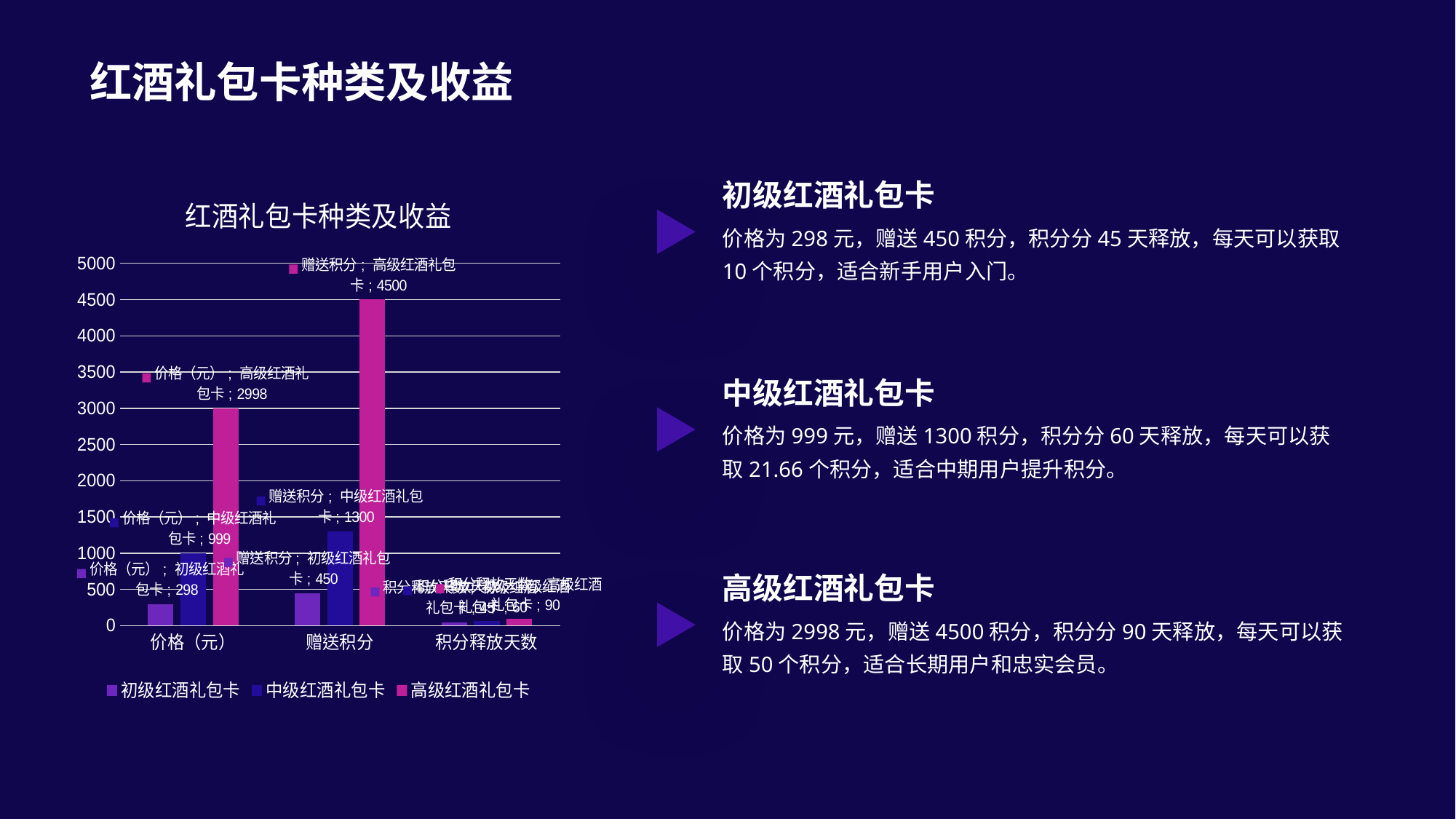
What is the difference between the 赠送积分 values of 高级红酒礼包卡 and 初级红酒礼包卡? 4050 How many series does the chart legend list? 3 Which series has the lowest 价格（元） value? 初级红酒礼包卡 How many categories are shown on the x axis of the chart? 3 What is the 价格（元） value for 初级红酒礼包卡? 298 Is the 积分释放天数 value for 高级红酒礼包卡 greater or less than 500? less What is the 价格（元） value for 高级红酒礼包卡? 2998 Which series has the highest 赠送积分 value? 高级红酒礼包卡 What type of chart is shown on the slide? bar chart What is the 赠送积分 value for 中级红酒礼包卡? 1300 Which is larger: the 价格（元） value for 中级红酒礼包卡 or the 赠送积分 value for 中级红酒礼包卡? 赠送积分 for 中级红酒礼包卡 What is the title of the chart? 红酒礼包卡种类及收益